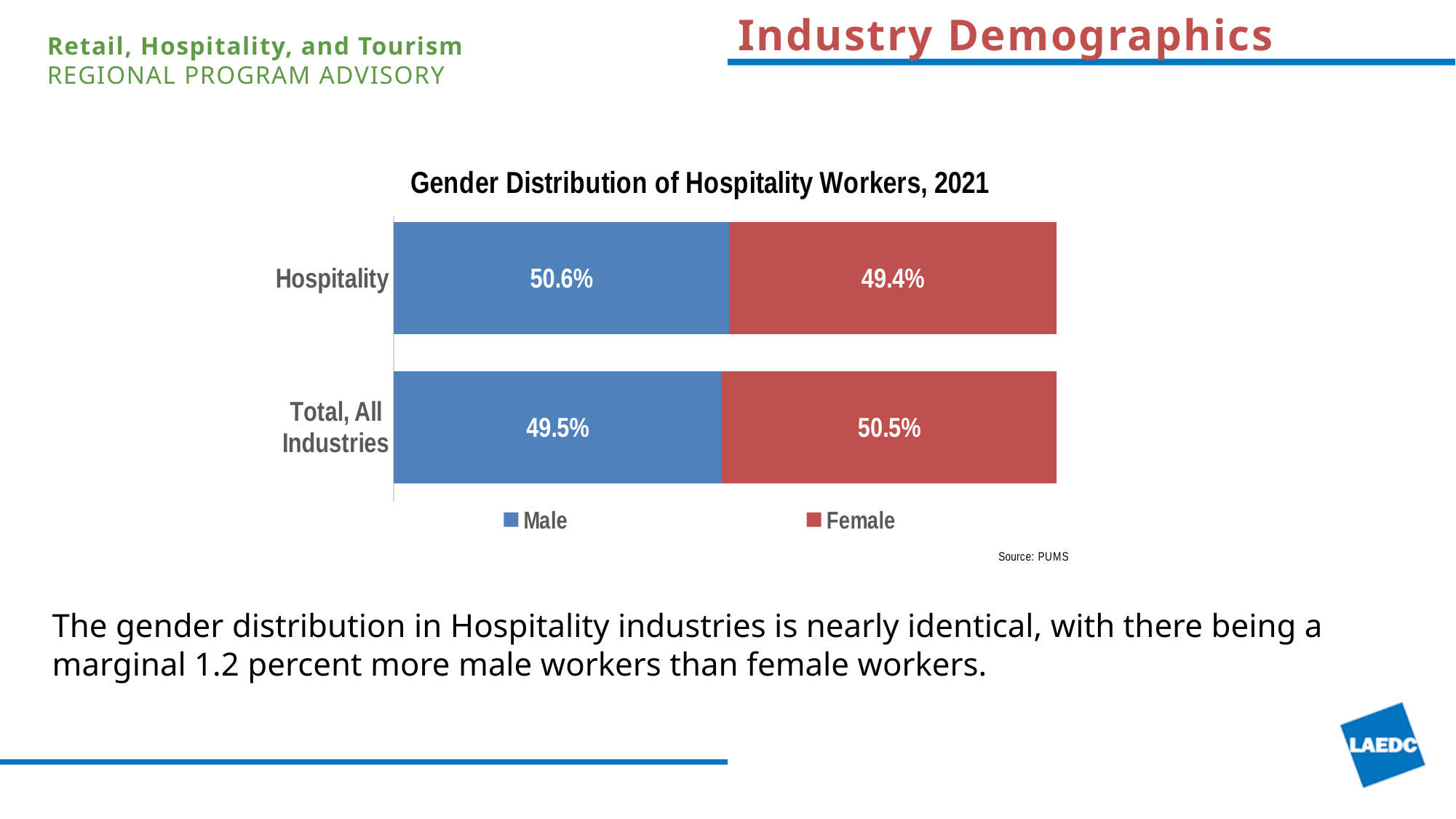
What is the difference between the Female and Male shares for Total, All Industries? 1.0% What is the Male share for Hospitality? 50.6% How many series does the legend list? 2 How many categories are shown on the chart? 2 What is the difference between the Male and Female shares for Hospitality? 1.2% What is the Male share for Total, All Industries? 49.5% Which category has the higher Male share, Hospitality or Total, All Industries? Hospitality What is the total of the Hospitality stacked bar? 100.0% What is the Female share for Hospitality? 49.4% What is the Female share for Total, All Industries? 50.5% What kind of chart is shown on the slide? Stacked bar chart Which category has the higher Female share, Hospitality or Total, All Industries? Total, All Industries